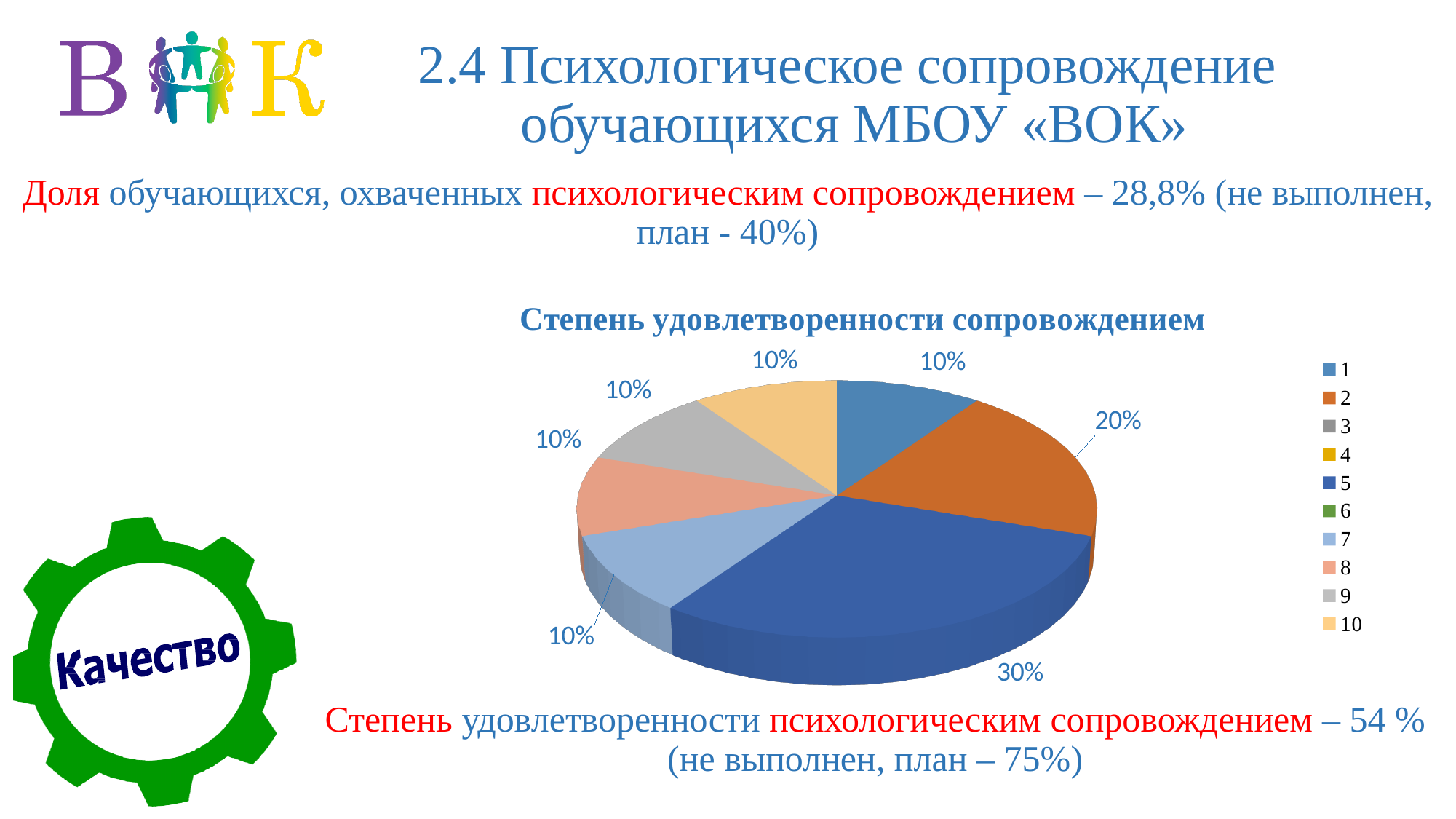
What share of the pie does category 5 have? 30% Which is larger, the slice for category 2 or the slice for category 1? 2 What colour is the slice for category 2? orange What is the value shown for category 9? 10% What kind of chart is shown on the slide? pie chart How many entries does the chart legend list? 10 What is the value shown for category 1? 10% What is the difference between the values for category 5 and category 2? 10% What is the value shown for category 2? 20% What is the title of the chart? Степень удовлетворенности сопровождением How many slices with data labels are visible in the pie chart? 7 Which category has the largest slice in the pie chart? 5